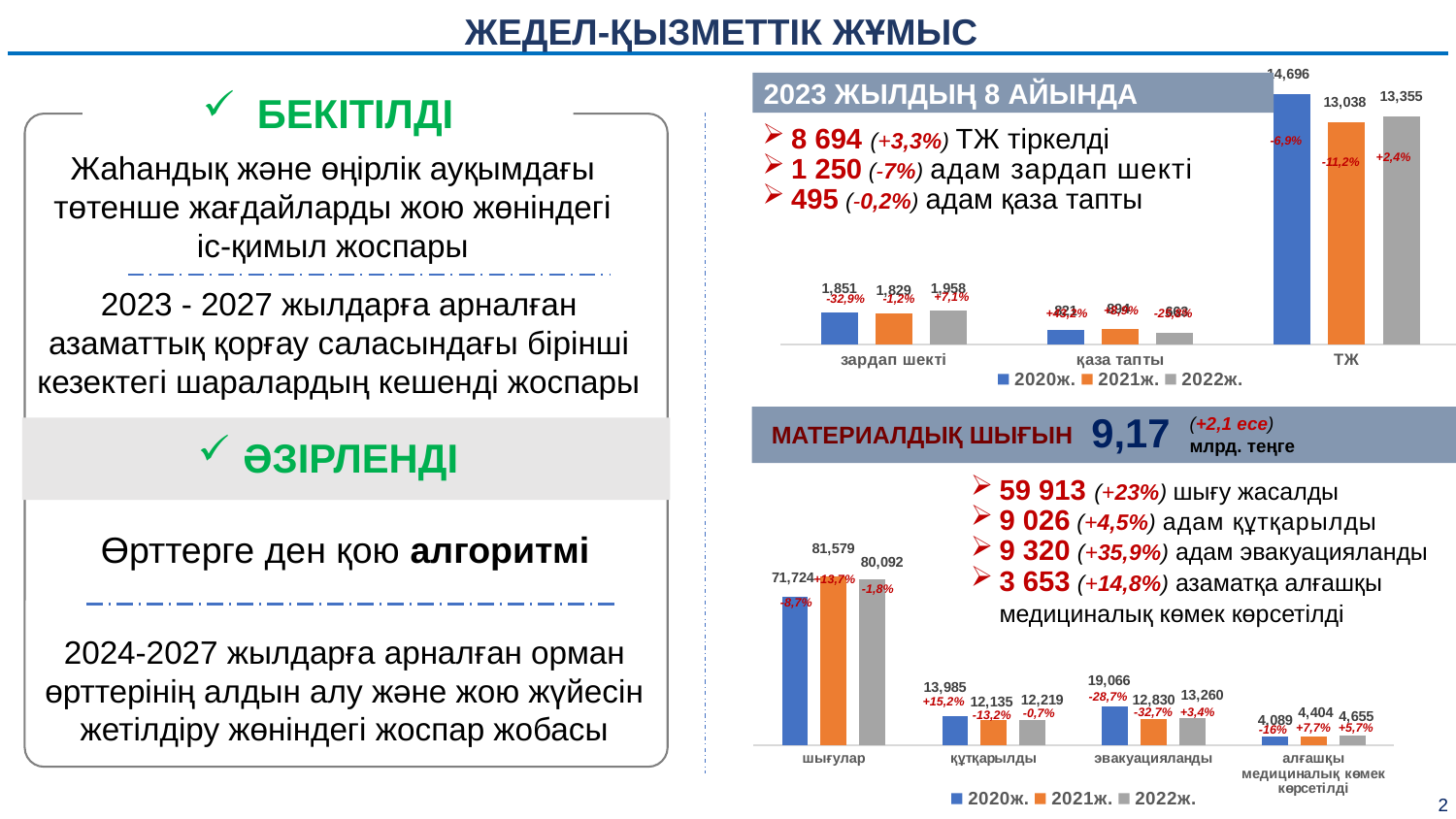
In the bottom right chart, how many categories are shown on the x axis? 4 In the top right chart, what is the value for ТЖ in 2021ж.? 13,038 What type of chart is the bottom right chart? Bar chart In the top right chart, what is the value for зардап шекті in 2022ж.? 1,958 In the top right chart, what is the difference between the ТЖ values for 2020ж. and 2022ж.? 1,341 In the bottom right chart, which is larger for құтқарылды: 2020ж. or 2022ж.? 2020ж. In the top right chart, which category has the highest values? ТЖ In the bottom right chart, what is the value for эвакуацияланды in 2020ж.? 19,066 In the bottom right chart, what is the value for шығулар in 2021ж.? 81,579 In the top right chart, what is the value for ТЖ in 2020ж.? 14,696 In the top right chart, how many series does the legend list? 3 In the bottom right chart, what is the value for алғашқы медициналық көмек көрсетілді in 2022ж.? 4,655